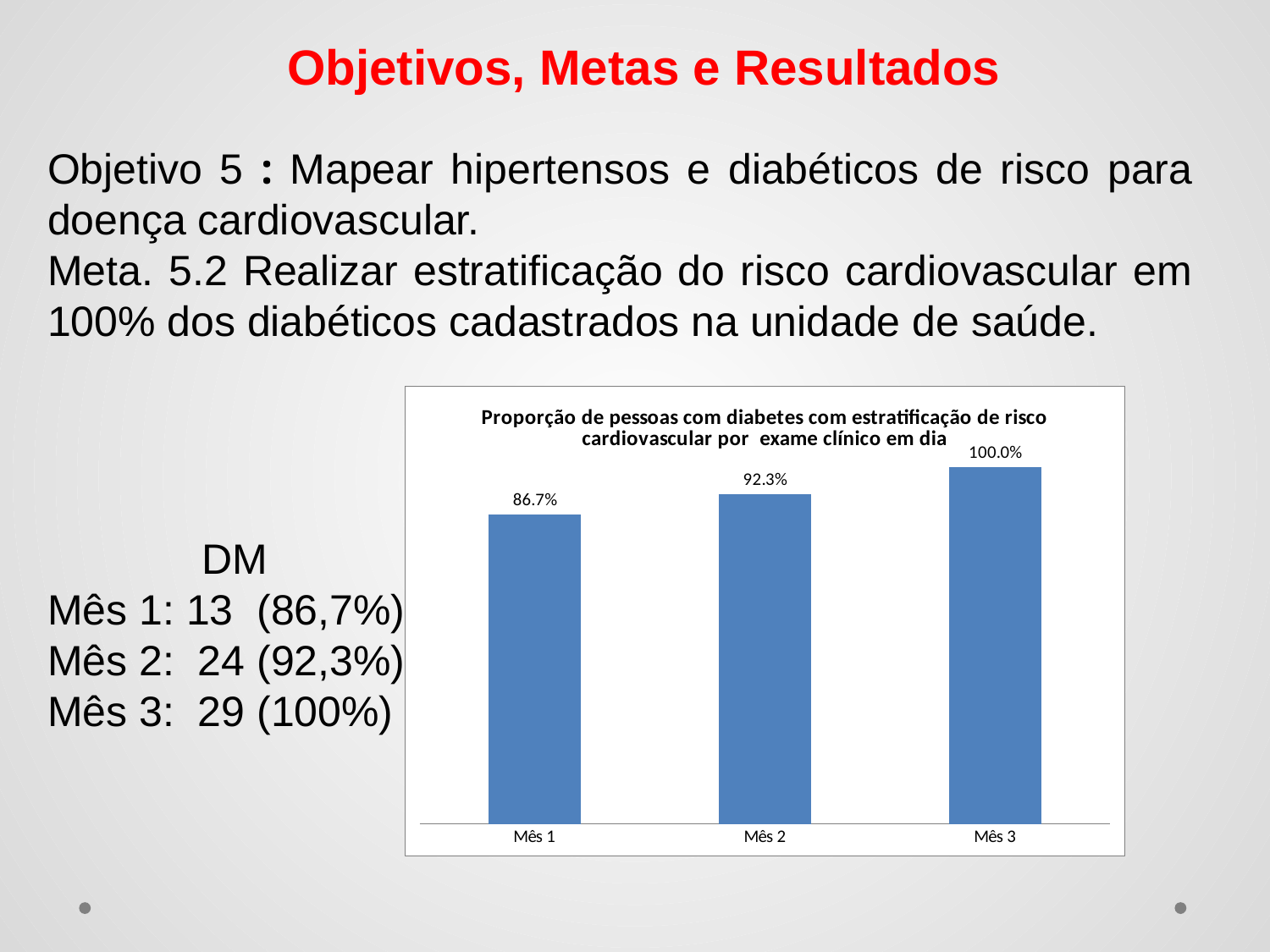
What is the value for Mês 2 in the chart? 92.3% What is the value for Mês 1 in the chart? 86.7% Which is larger, the value for Mês 2 or the value for Mês 1? Mês 2 What kind of chart is shown on the slide? Bar chart Which month has the lowest value in the chart? Mês 1 What is the difference between the values for Mês 2 and Mês 1? 5.6% Which month has the highest value in the chart? Mês 3 What is the value for Mês 3 in the chart? 100.0% How many months (categories) are shown in the chart? 3 What is the title of the chart? Proporção de pessoas com diabetes com estratificação de risco cardiovascular por exame clínico em dia What is the difference between the values for Mês 3 and Mês 1? 13.3% Do the values rise or fall from Mês 1 to Mês 3? Rise